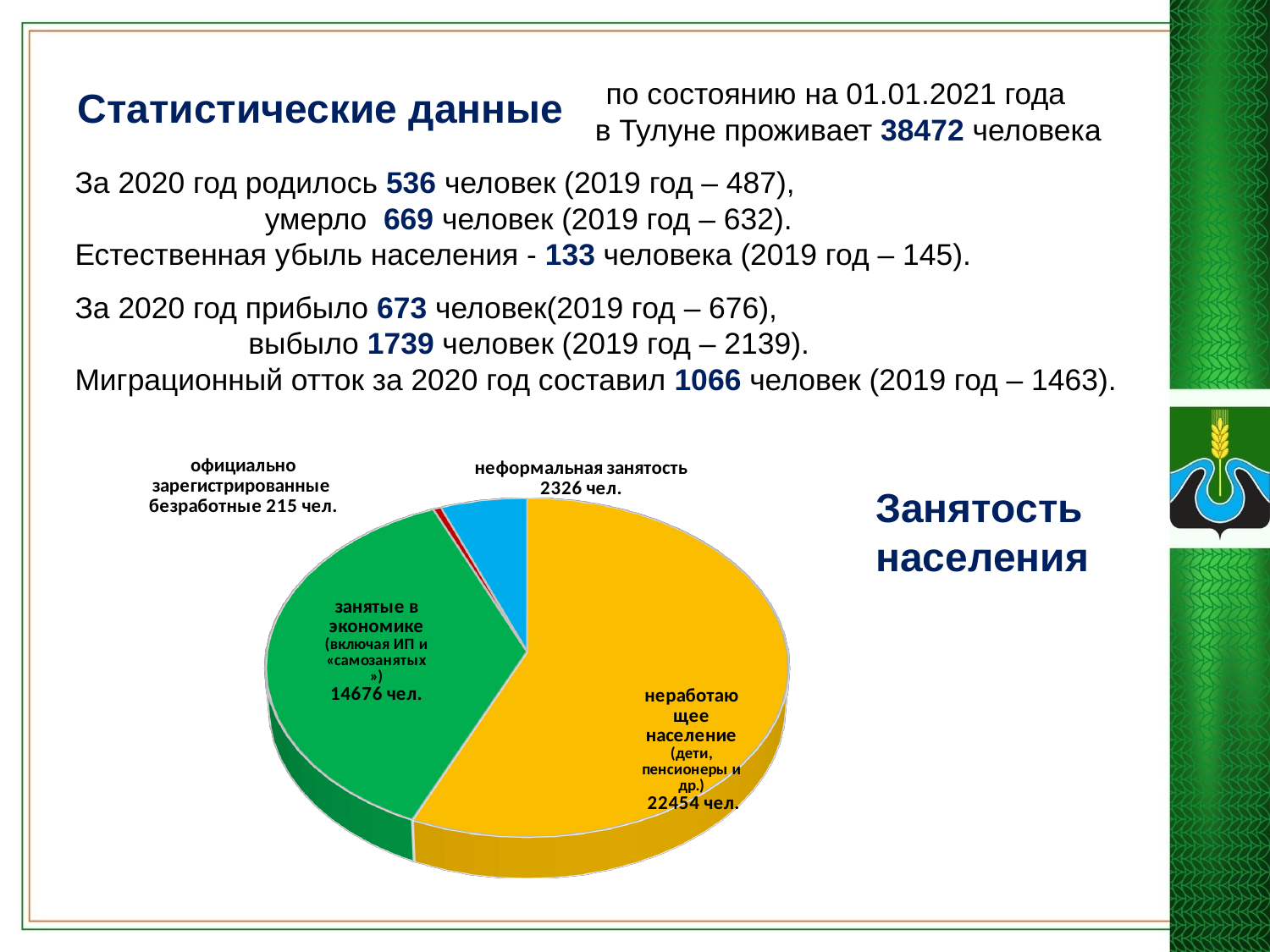
In the pie chart, what is the difference between «неформальная занятость» and «официально зарегистрированные безработные»? 2111 чел. In the pie chart, what is the difference between «неработающее население» and «занятые в экономике»? 7778 чел. What colour is the slice for «занятые в экономике» in the pie chart? green What kind of chart is shown on the slide under the heading «Занятость населения»? pie chart In the pie chart, what is the value for «неработающее население (дети, пенсионеры и др.)»? 22454 чел. In the pie chart, what is the value for «неформальная занятость»? 2326 чел. Which slice of the pie chart is the smallest? официально зарегистрированные безработные In the pie chart, which is larger: «занятые в экономике» or «неформальная занятость»? занятые в экономике Which slice of the pie chart is the largest? неработающее население (дети, пенсионеры и др.) In the pie chart, what is the value for «занятые в экономике (включая ИП и «самозанятых»)»? 14676 чел. How many slices does the pie chart «Занятость населения» have? 4 In the pie chart, what is the value for «официально зарегистрированные безработные»? 215 чел.